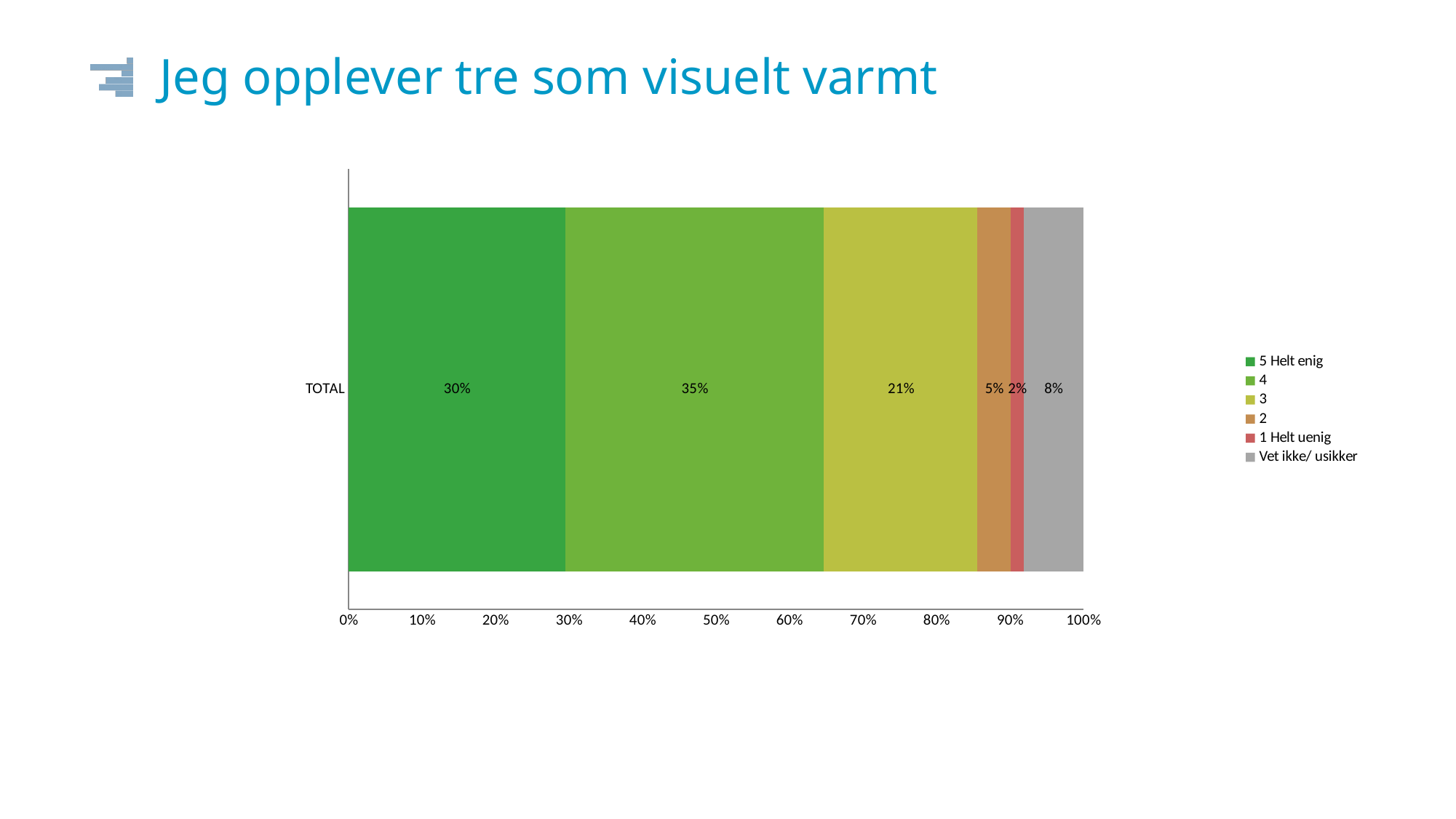
How many series does the legend list? 6 What kind of chart is shown on the slide? Stacked bar chart Which response category has the smallest share of the TOTAL bar? 1 Helt uenig What is the difference between the share for "4" and the share for "5 Helt enig"? 5% What percentage of respondents answered "3"? 21% Which response category has the largest share of the TOTAL bar? 4 What percentage of respondents answered "5 Helt enig"? 30% What percentage of respondents answered "4"? 35% What percentage of respondents answered "Vet ikke/ usikker"? 8% What is the title of the slide? Jeg opplever tre som visuelt varmt What is the combined share of "5 Helt enig" and "4"? 65% Which is larger, the share for "3" or the share for "Vet ikke/ usikker"? 3